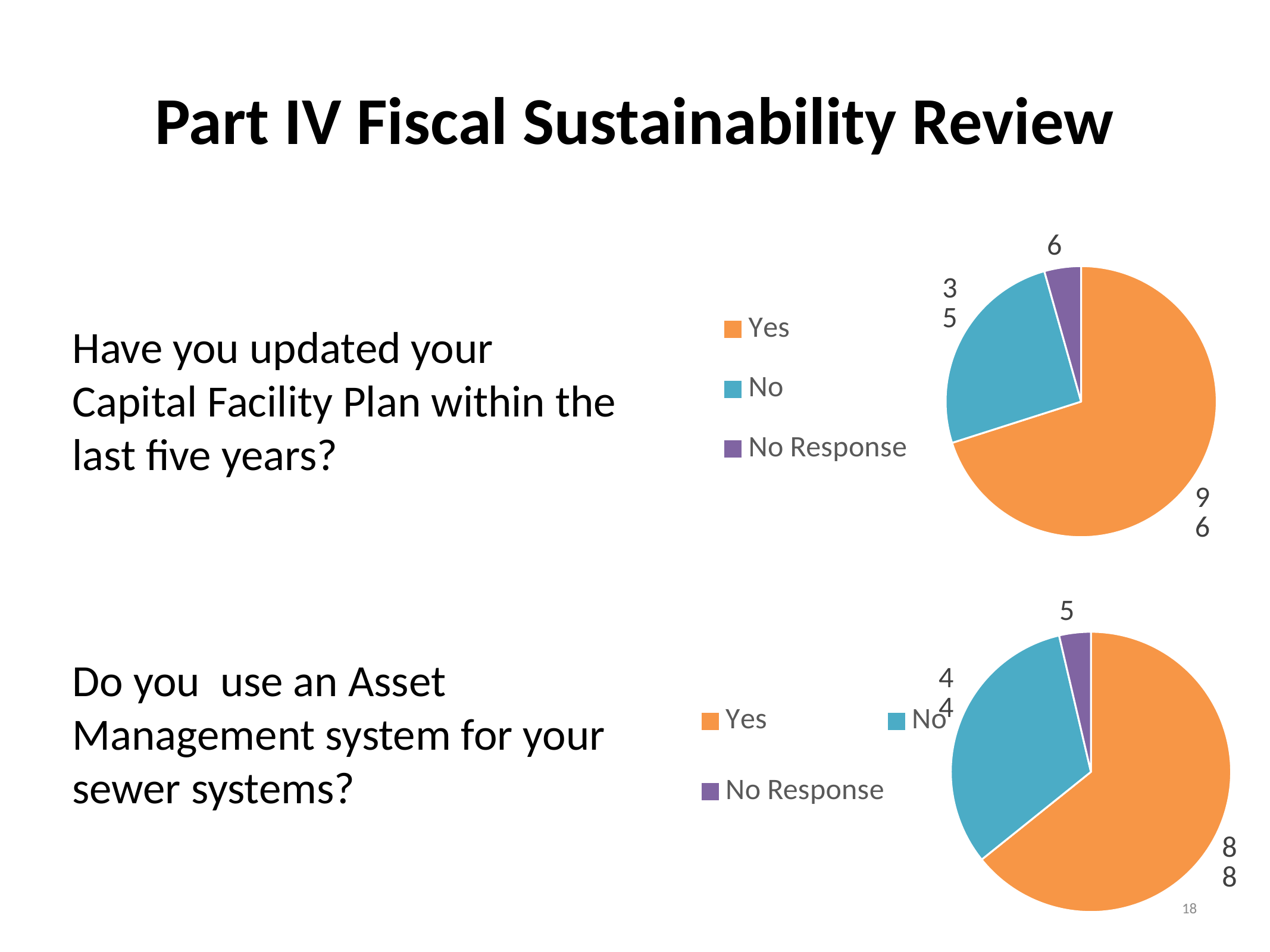
On the bottom pie chart, what is the total of all three slices? 137 On the top pie chart, which category has the largest slice? Yes How many categories does the legend of the top pie chart list? 3 On the top pie chart, what is the difference between the Yes and No values? 61 On the bottom pie chart (Asset Management system question), what is the value for No? 44 On the top pie chart (Capital Facility Plan question), what is the value for No Response? 6 On the top pie chart (Capital Facility Plan question), what is the value for No? 35 On the bottom pie chart, which category has the smallest slice? No Response On the top pie chart (Capital Facility Plan question), what is the value for Yes? 96 On the bottom pie chart (Asset Management system question), what is the value for Yes? 88 On the bottom pie chart (Asset Management system question), what is the value for No Response? 5 What type of chart is used for the Asset Management system question? Pie chart